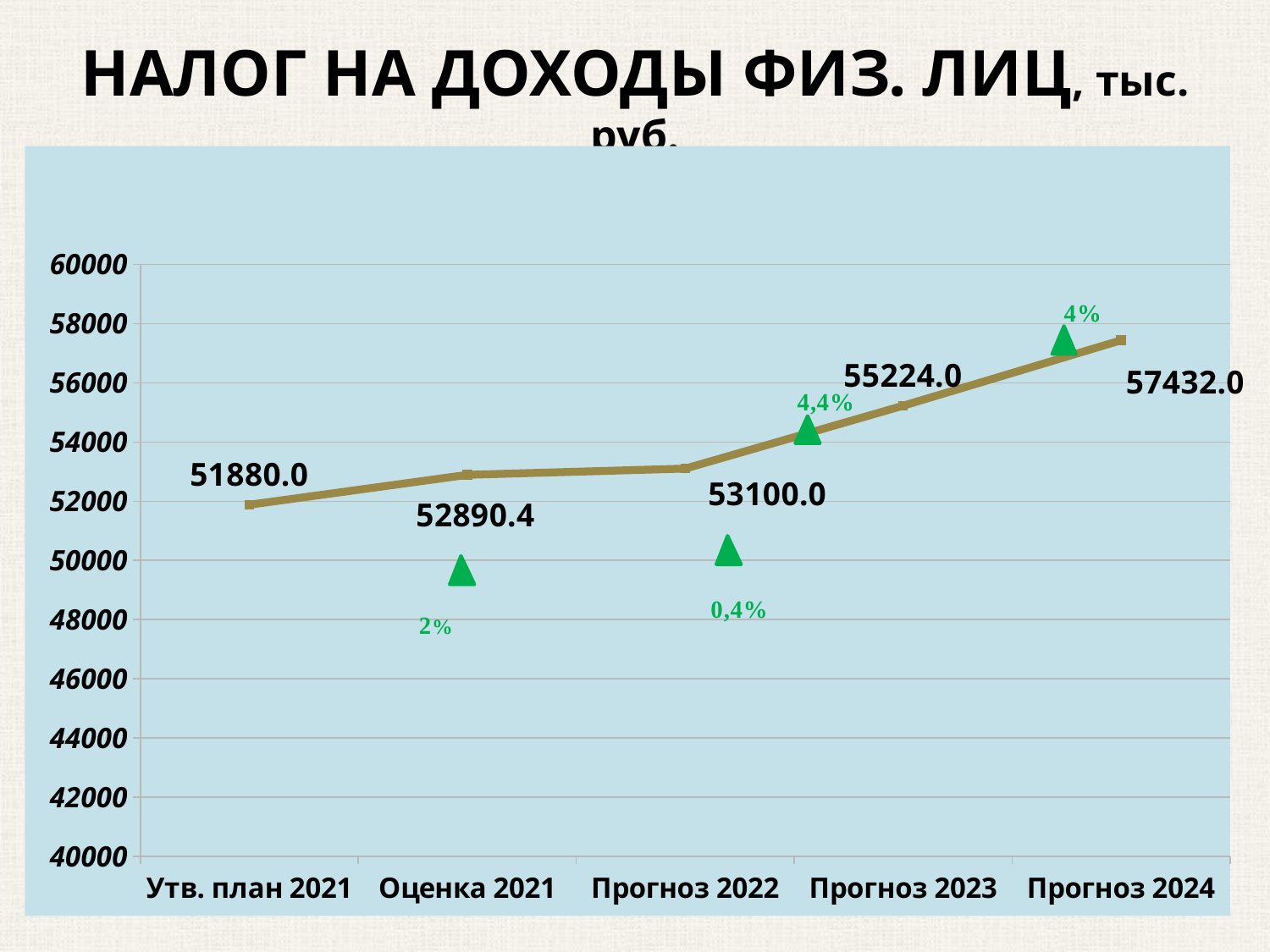
How many categories are shown on the x axis? 5 What is the value for Прогноз 2023? 55224.0 Which category has the highest value? Прогноз 2024 What is the value for Прогноз 2024? 57432.0 What is the value for Оценка 2021? 52890.4 What is the difference between the values for Прогноз 2024 and Прогноз 2023? 2208.0 What is the value for Утв. план 2021? 51880.0 Which category has the lowest value? Утв. план 2021 Which is larger, the value for Прогноз 2022 or the value for Оценка 2021? Прогноз 2022 What percentage change is labelled next to the green triangle at Прогноз 2023? 4,4% What kind of chart is shown on the slide? Line chart Do the values rise or fall from Утв. план 2021 to Прогноз 2024? Rise